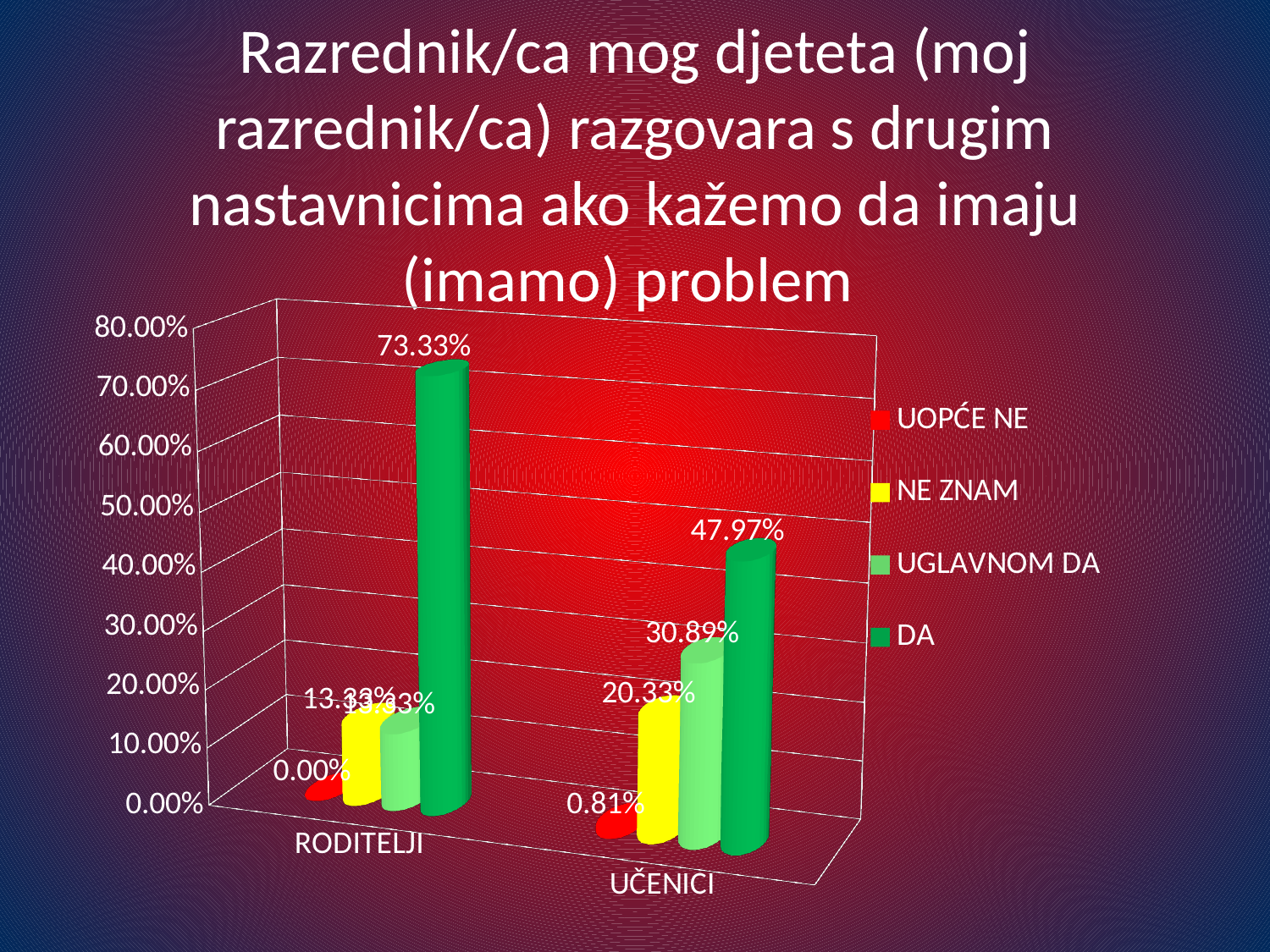
How many categories are shown on the x axis? 2 In the UČENICI category, which is larger: UGLAVNOM DA or NE ZNAM? UGLAVNOM DA What is the value for NE ZNAM in the UČENICI category? 20.33% What is the value for UOPĆE NE in the UČENICI category? 0.81% What is the value for DA in the RODITELJI category? 73.33% What is the value for UGLAVNOM DA in the UČENICI category? 30.89% What is the difference between the DA value for RODITELJI and the DA value for UČENICI? 25.36% How many series does the legend list? 4 What is the value for UOPĆE NE in the RODITELJI category? 0.00% What is the value for DA in the UČENICI category? 47.97% What kind of chart is shown on the slide? bar chart Which series has the highest value in the RODITELJI category? DA